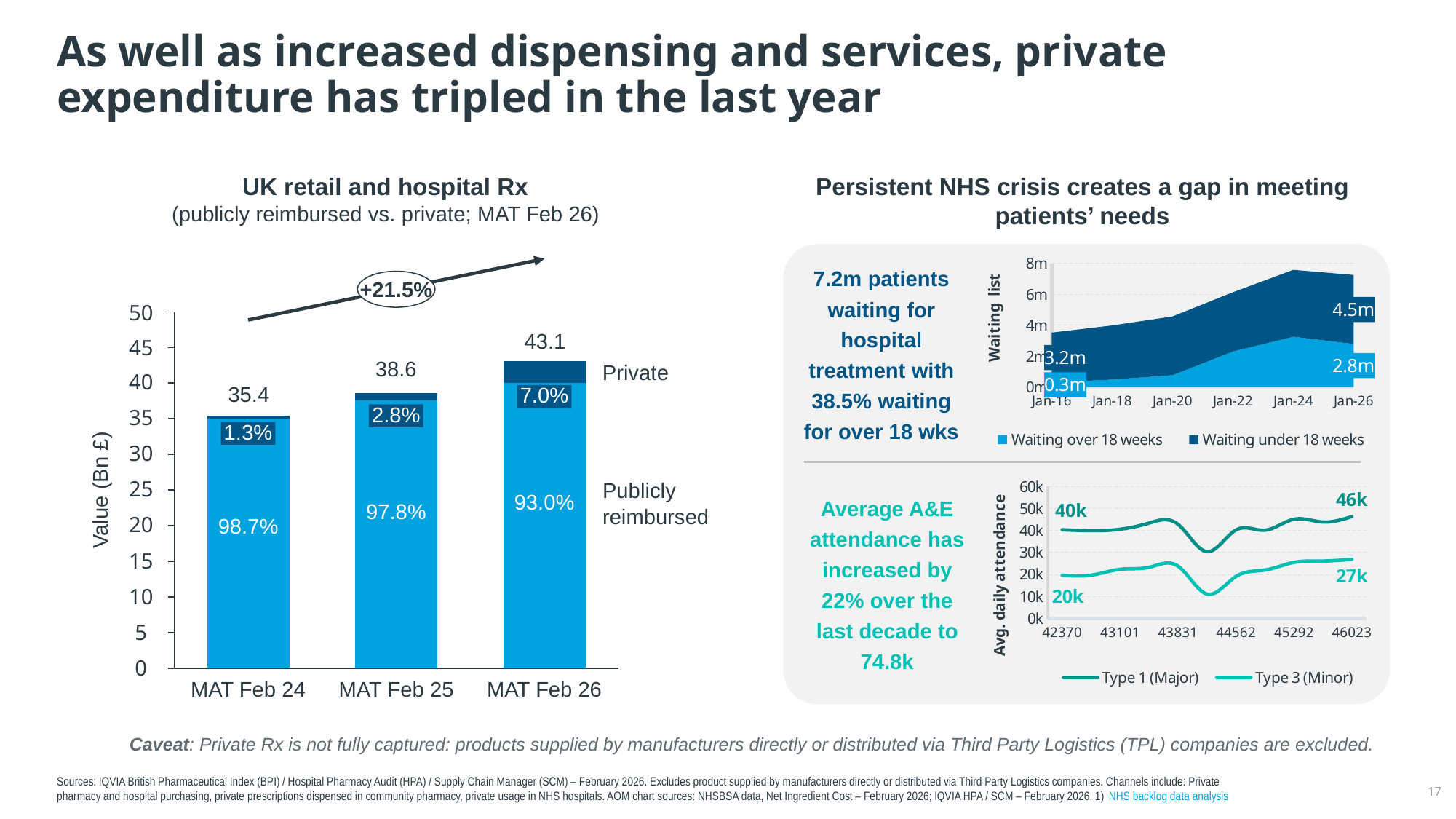
In the average daily attendance line chart, which series has the higher final value, Type 1 (Major) or Type 3 (Minor)? Type 1 (Major) In the waiting list chart on the right, what is the value for 'Waiting over 18 weeks' at Jan-26? 2.8m What growth percentage is annotated above the bars in the 'UK retail and hospital Rx' bar chart? +21.5% In the 'UK retail and hospital Rx' bar chart, which period has the highest total value? MAT Feb 26 In the 'UK retail and hospital Rx' bar chart, what is the total value for MAT Feb 26? 43.1 How many series does the legend of the waiting list chart on the right list? 2 How many periods are shown on the x axis of the 'UK retail and hospital Rx' bar chart? 3 In the 'UK retail and hospital Rx' bar chart, do the total values rise or fall from MAT Feb 24 to MAT Feb 26? Rise What kind of chart is the 'UK retail and hospital Rx' chart? Bar chart In the average daily attendance line chart, what is the final labelled value for Type 1 (Major)? 46k In the 'UK retail and hospital Rx' bar chart, what is the difference between the total values for MAT Feb 26 and MAT Feb 24? 7.7 In the 'UK retail and hospital Rx' bar chart, what percentage of the MAT Feb 25 bar is Private? 2.8%